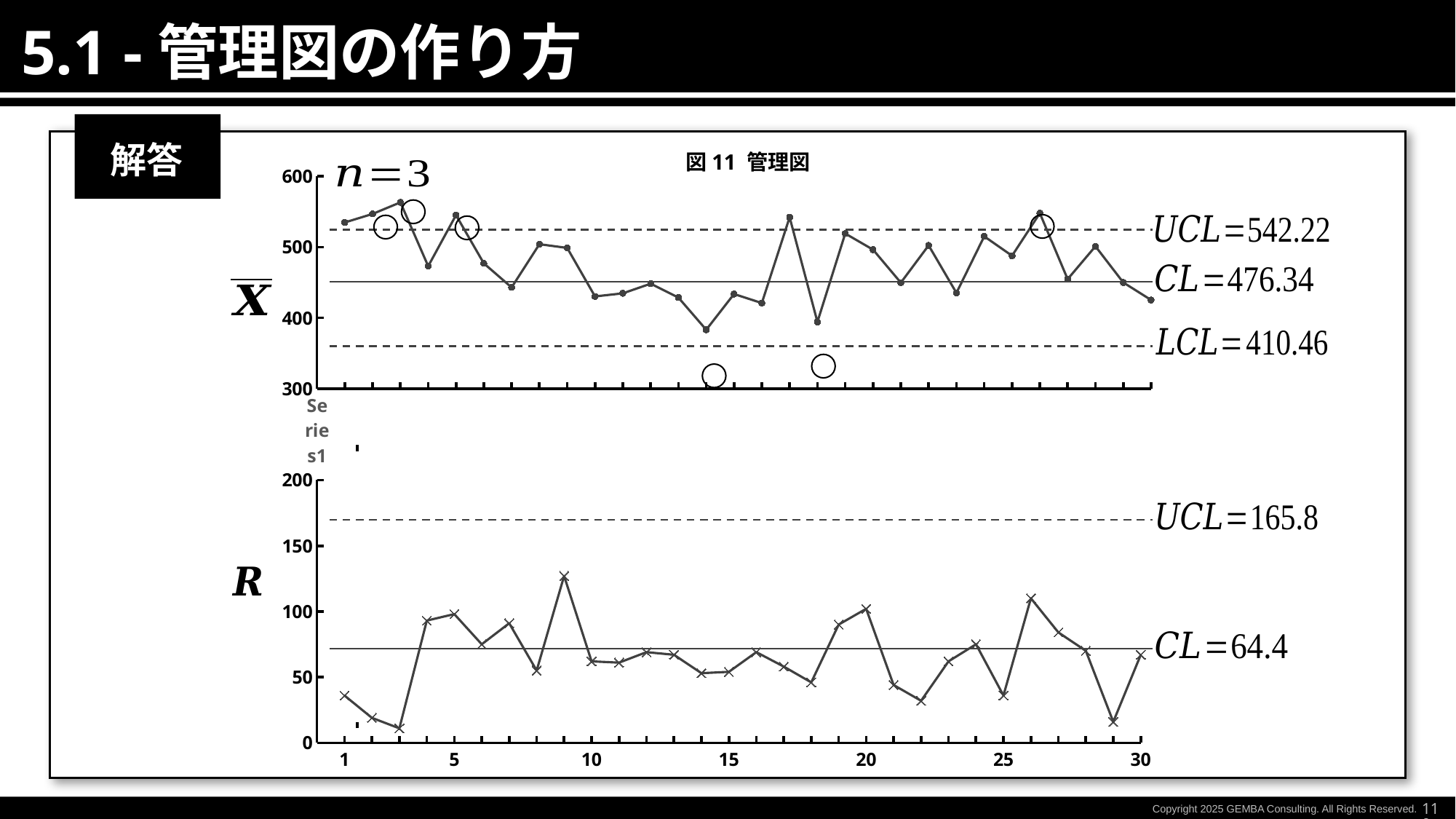
In the bottom R chart, which sample number has the highest R value? 9 In the top X̄ chart, what is the value of LCL? 410.46 In the top X̄ chart, what is the value of CL? 476.34 What is the title of the chart on the slide? 図 11 管理図 In the bottom R chart, is the value for sample 9 greater or less than 100? greater In the top X̄ chart, what is the value of UCL? 542.22 In the bottom R chart, what is the value of UCL? 165.8 How many sample points are plotted along the x axis of the R chart? 30 In the top X̄ chart, what is the difference between UCL and CL? 65.88 In the top X̄ chart, is the value for sample 14 greater or less than 400? less In the bottom R chart, what is the value of CL? 64.4 What kind of chart is the top (X̄) chart? line chart